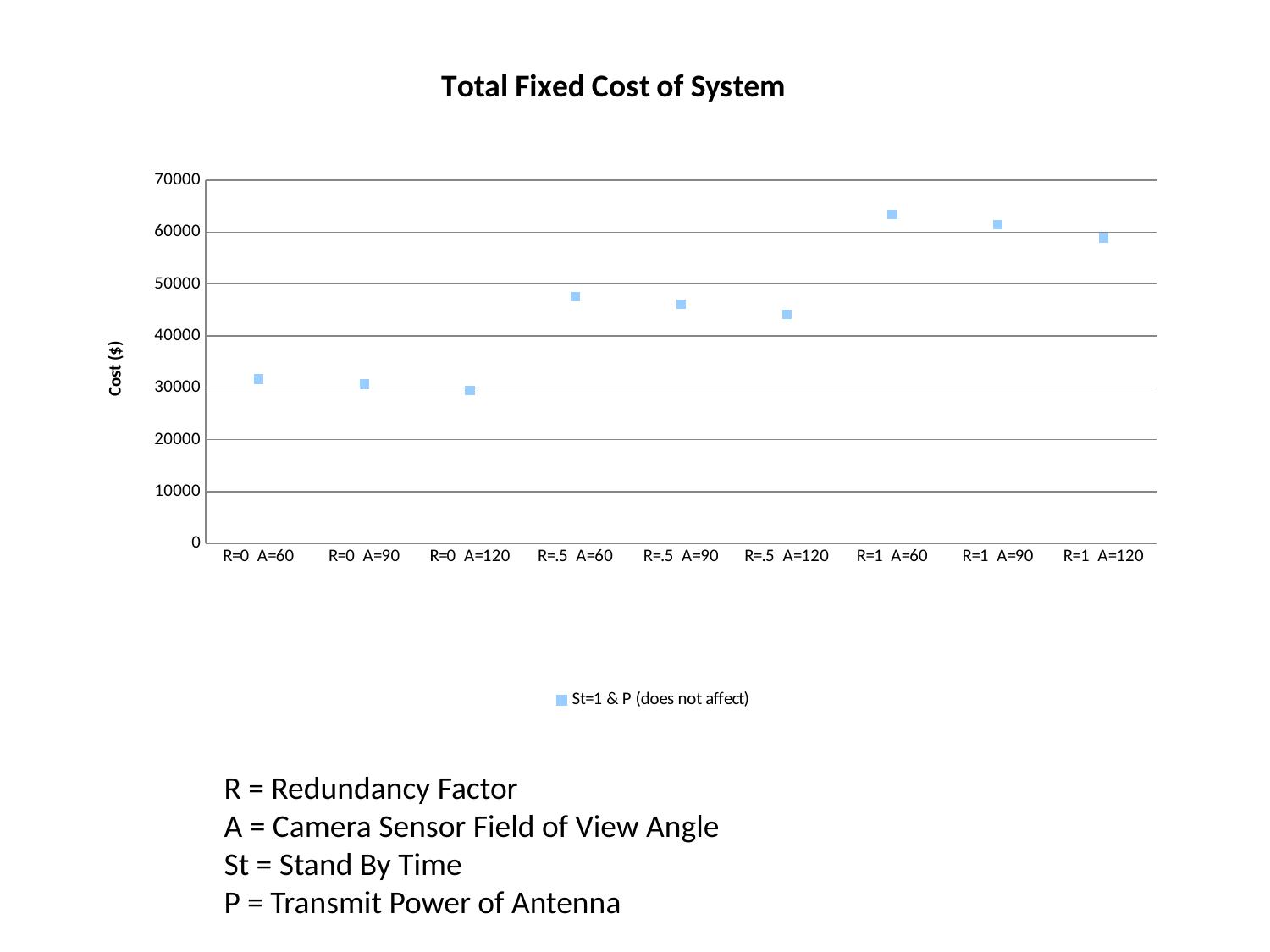
Which is larger, the value for R=.5 A=90 or the value for R=1 A=90? R=1 A=90 How many series does the legend list? 1 Is the value for R=0 A=60 greater or less than 40000? less Is the value for R=.5 A=120 greater or less than 40000? greater Is the value for R=1 A=60 greater or less than 60000? greater What kind of chart is shown on the slide? scatter chart What is the title of the chart? Total Fixed Cost of System Within the R=1 group, do the values rise or fall as A increases from 60 to 120? fall What is the label on the vertical axis of the chart? Cost ($) Which category has the highest cost? R=1 A=60 How many categories are plotted along the x axis? 9